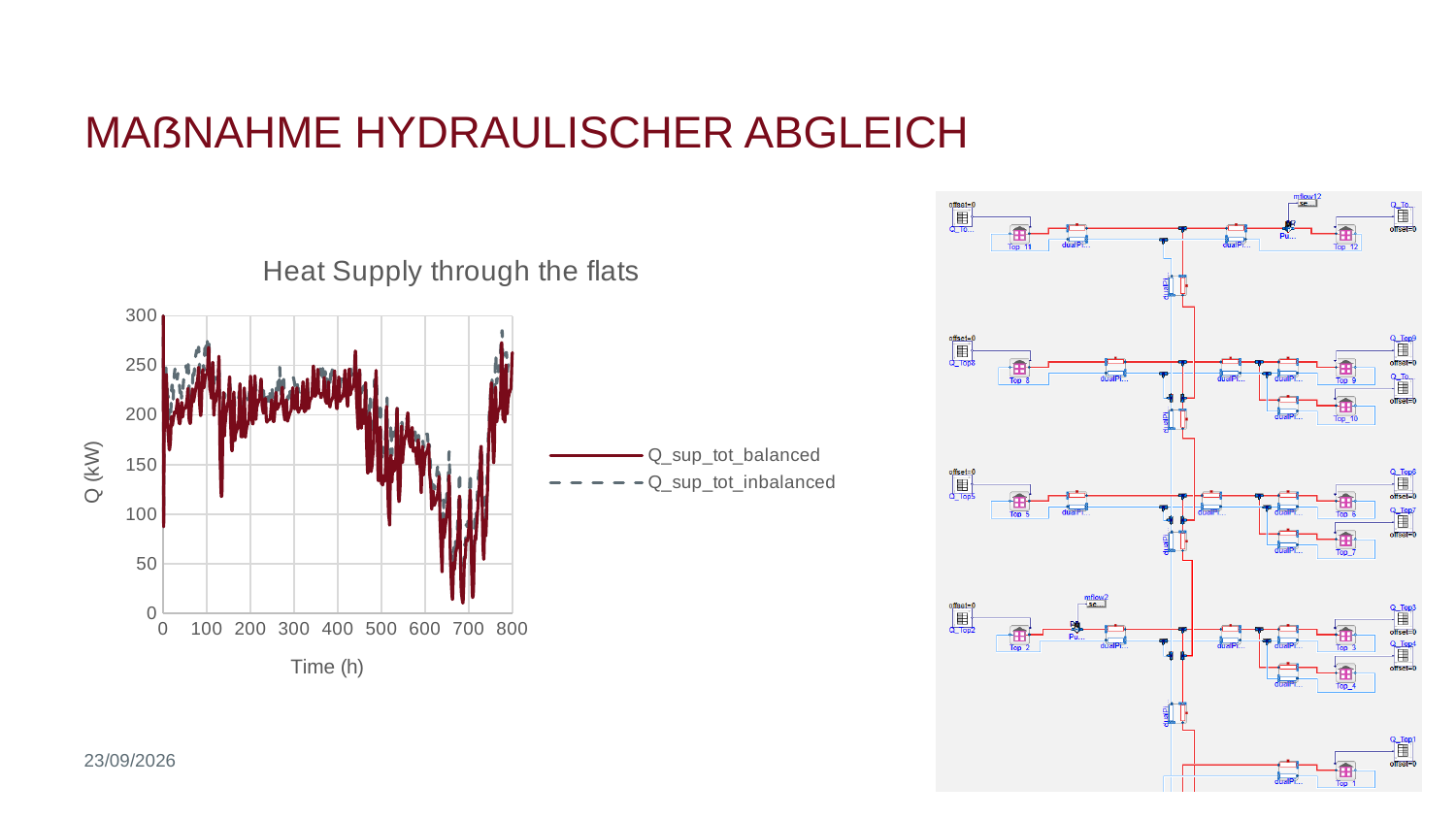
What are the two series named in the legend of the 'Heat Supply through the flats' chart? Q_sup_tot_balanced and Q_sup_tot_inbalanced What is the title of the chart on the left of the slide? Heat Supply through the flats In the 'Heat Supply through the flats' chart, do the Q_sup_tot_balanced values generally rise or fall between 700 h and 800 h? rise What kind of chart is 'Heat Supply through the flats'? line chart In the 'Heat Supply through the flats' chart, do the Q_sup_tot_balanced values generally rise or fall between 400 h and 700 h? fall In the 'Heat Supply through the flats' chart, is the Q_sup_tot_balanced value at around 650 h greater or less than 200? less In the 'Heat Supply through the flats' chart, is the Q_sup_tot_inbalanced value at around 400 h greater or less than 100? greater In the 'Heat Supply through the flats' chart, is the Q_sup_tot_balanced value at around 200 h greater or less than 100? greater How many series does the legend of the 'Heat Supply through the flats' chart list? 2